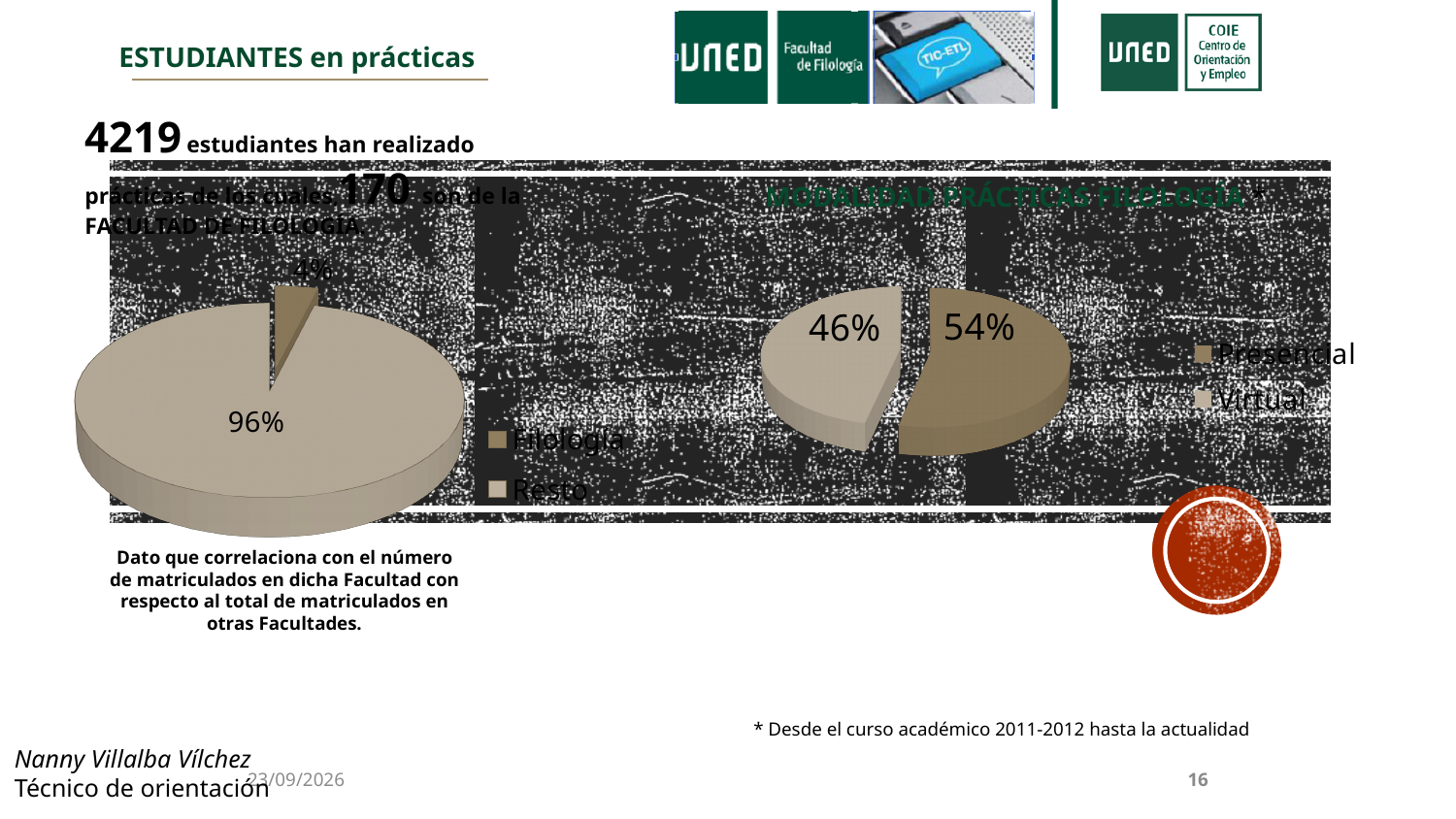
On the chart titled MODALIDAD PRÁCTICAS FILOLOGÍA, what share is shown for Presencial? 54% How many entries does the legend of the chart titled MODALIDAD PRÁCTICAS FILOLOGÍA list? 2 What is the title of the pie chart on the right of the slide? MODALIDAD PRÁCTICAS FILOLOGÍA * On the chart titled MODALIDAD PRÁCTICAS FILOLOGÍA, what is the difference in percentage points between Presencial and Virtual? 8 On the chart titled MODALIDAD PRÁCTICAS FILOLOGÍA, which modality has the larger share? Presencial How many slices does the left pie chart have? 2 On the left pie chart, what share is labelled for Filología? 4% On the chart titled MODALIDAD PRÁCTICAS FILOLOGÍA, what share is shown for Virtual? 46% On the left pie chart, what share is labelled for Resto? 96% What type of chart is the chart titled MODALIDAD PRÁCTICAS FILOLOGÍA? Pie chart On the left pie chart, what is the difference in percentage points between Resto and Filología? 92 On the left pie chart, which category has the smaller share? Filología